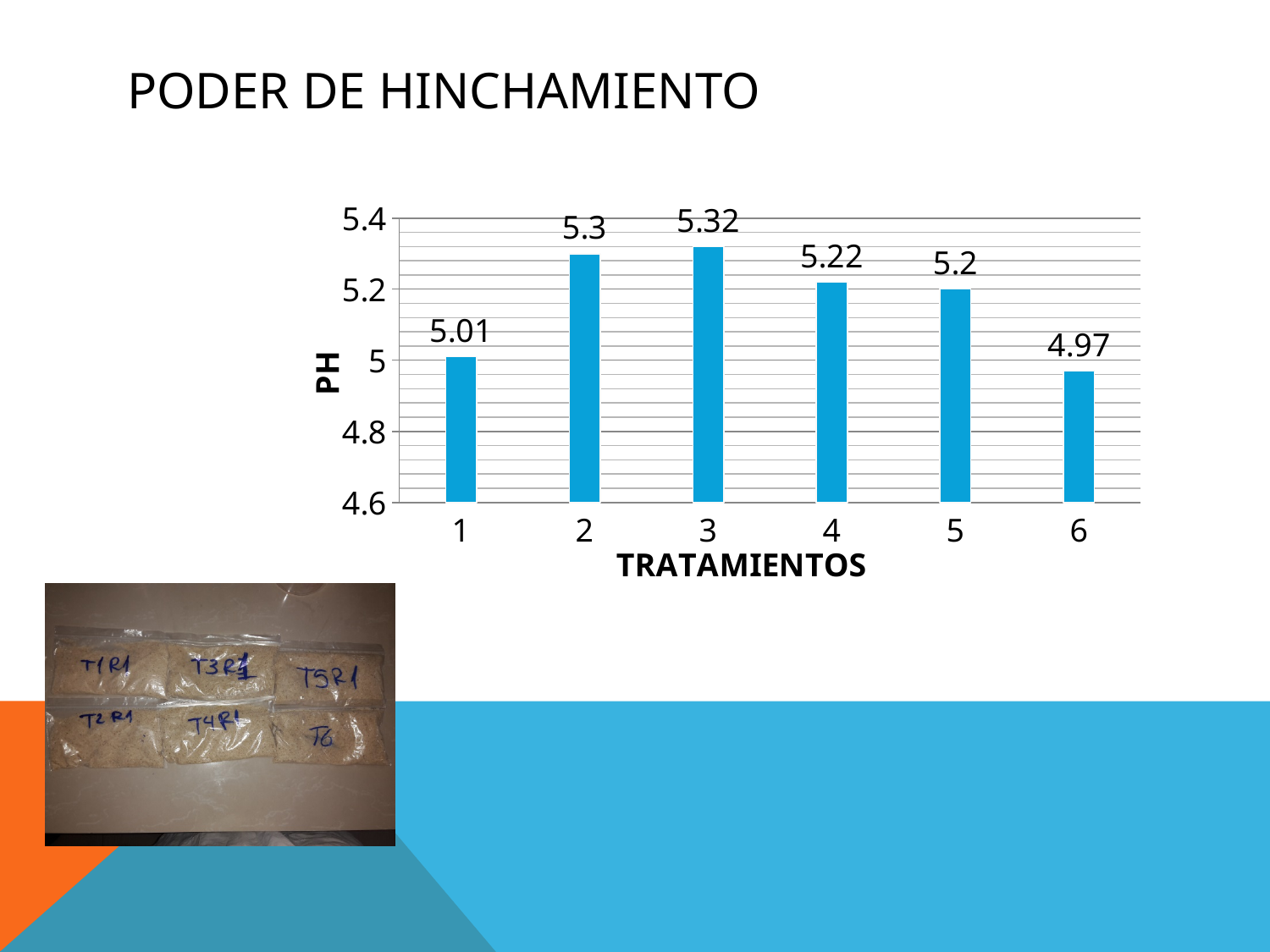
Which tratamiento has the highest PH value? 3 What is the difference between the PH values of tratamiento 2 and tratamiento 5? 0.1 Which has a higher PH value, tratamiento 1 or tratamiento 5? Tratamiento 5 How many tratamientos are shown on the x axis of the chart? 6 What is the PH value for tratamiento 6? 4.97 Which tratamiento has the lowest PH value? 6 What kind of chart is shown on the slide? Bar chart What is the PH value for tratamiento 1? 5.01 What is the PH value for tratamiento 4? 5.22 What is the label of the y axis of the chart? PH Is the PH value for tratamiento 6 greater or less than 5? less What is the difference between the PH values of tratamiento 3 and tratamiento 6? 0.35